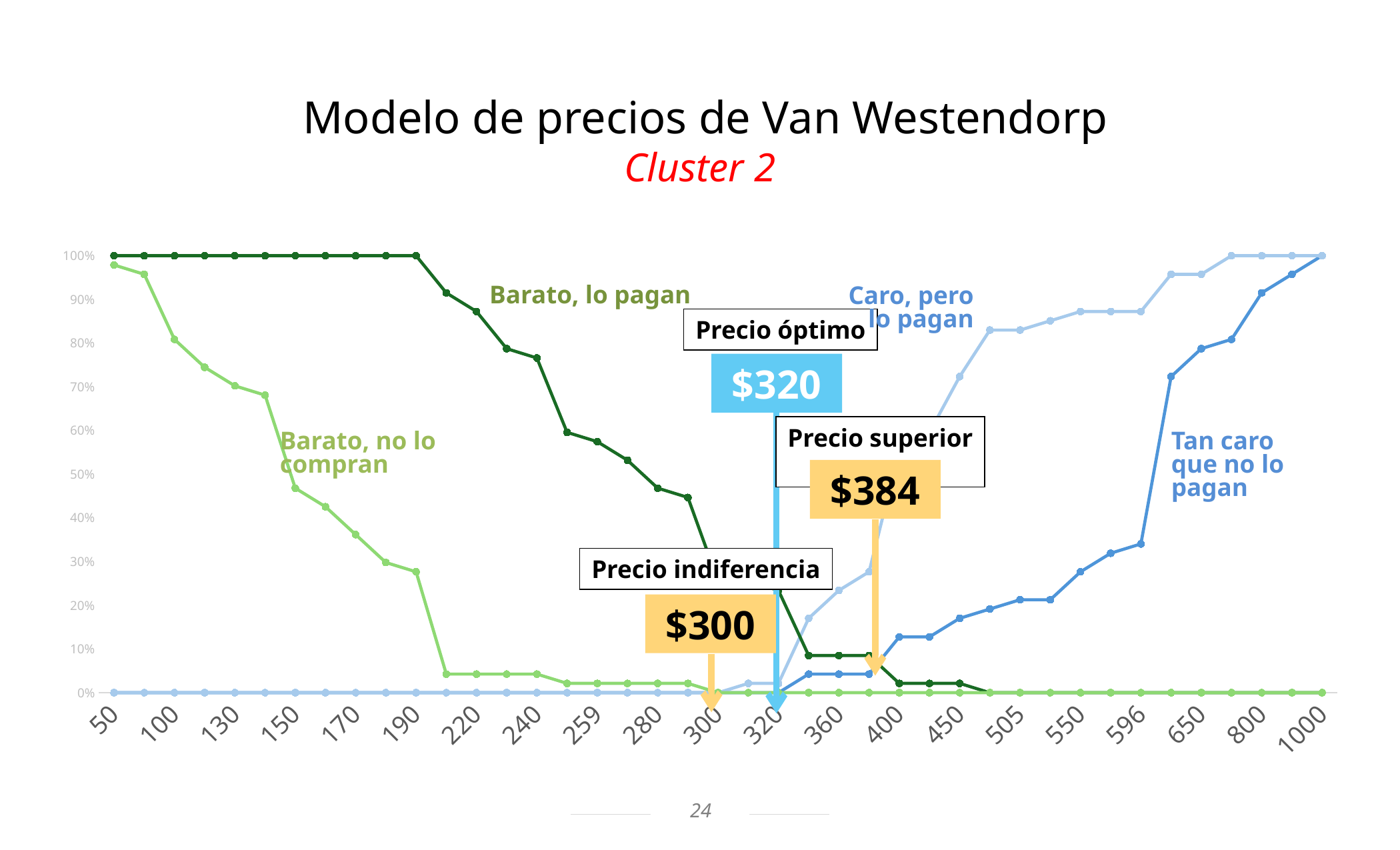
How many data series are plotted on the chart? 4 What is the value of the 'Barato, lo pagan' series at 50? 100% What is the value shown for 'Precio óptimo'? $320 Does the 'Barato, lo pagan' series rise or fall as the price increases along the x axis? fall At 400, which series has the larger value: 'Caro, pero lo pagan' or 'Tan caro que no lo pagan'? Caro, pero lo pagan What is the value shown for 'Precio indiferencia'? $300 What kind of chart is shown on the slide? line chart Is the value of 'Barato, lo pagan' at 240 greater or less than 70%? greater What is the value shown for 'Precio superior'? $384 What is the value of the 'Tan caro que no lo pagan' series at 1000? 100% Is the value of 'Barato, no lo compran' at 170 greater or less than 50%? less What is the title of the chart on the slide? Modelo de precios de Van Westendorp